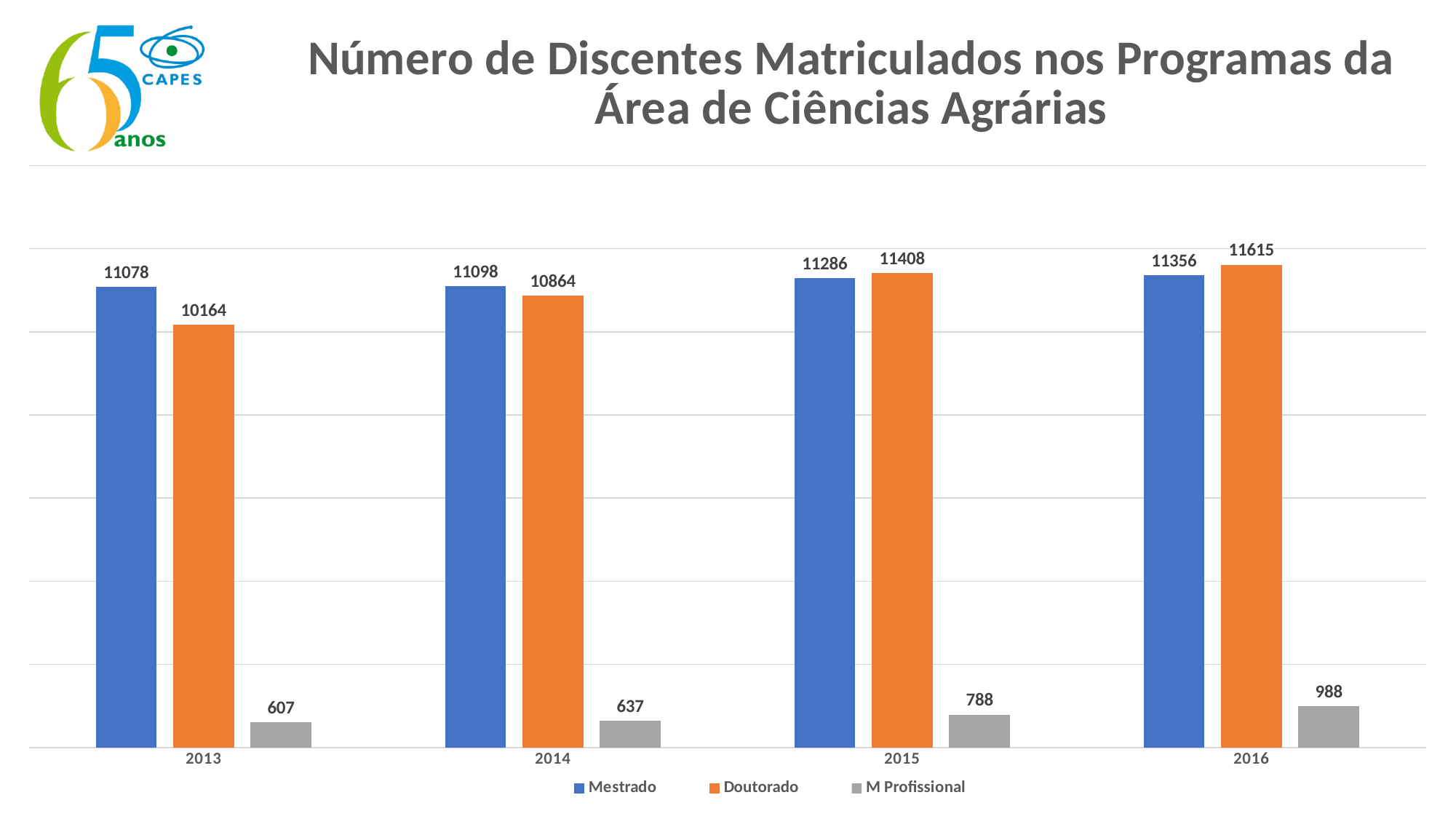
How many series does the legend list? 3 What is the value for Mestrado in 2013? 11078 In which year is the M Profissional value lowest? 2013 What kind of chart is shown on the slide? Bar chart Which is larger in 2015, Mestrado or Doutorado? Doutorado What is the value for M Profissional in 2015? 788 What is the value for Doutorado in 2016? 11615 In which year is the Doutorado value highest? 2016 Do the M Profissional values rise or fall from 2013 to 2016? Rise What is the difference between the Mestrado and Doutorado values in 2013? 914 What colour are the Doutorado bars? Orange How many years are shown on the x axis? 4